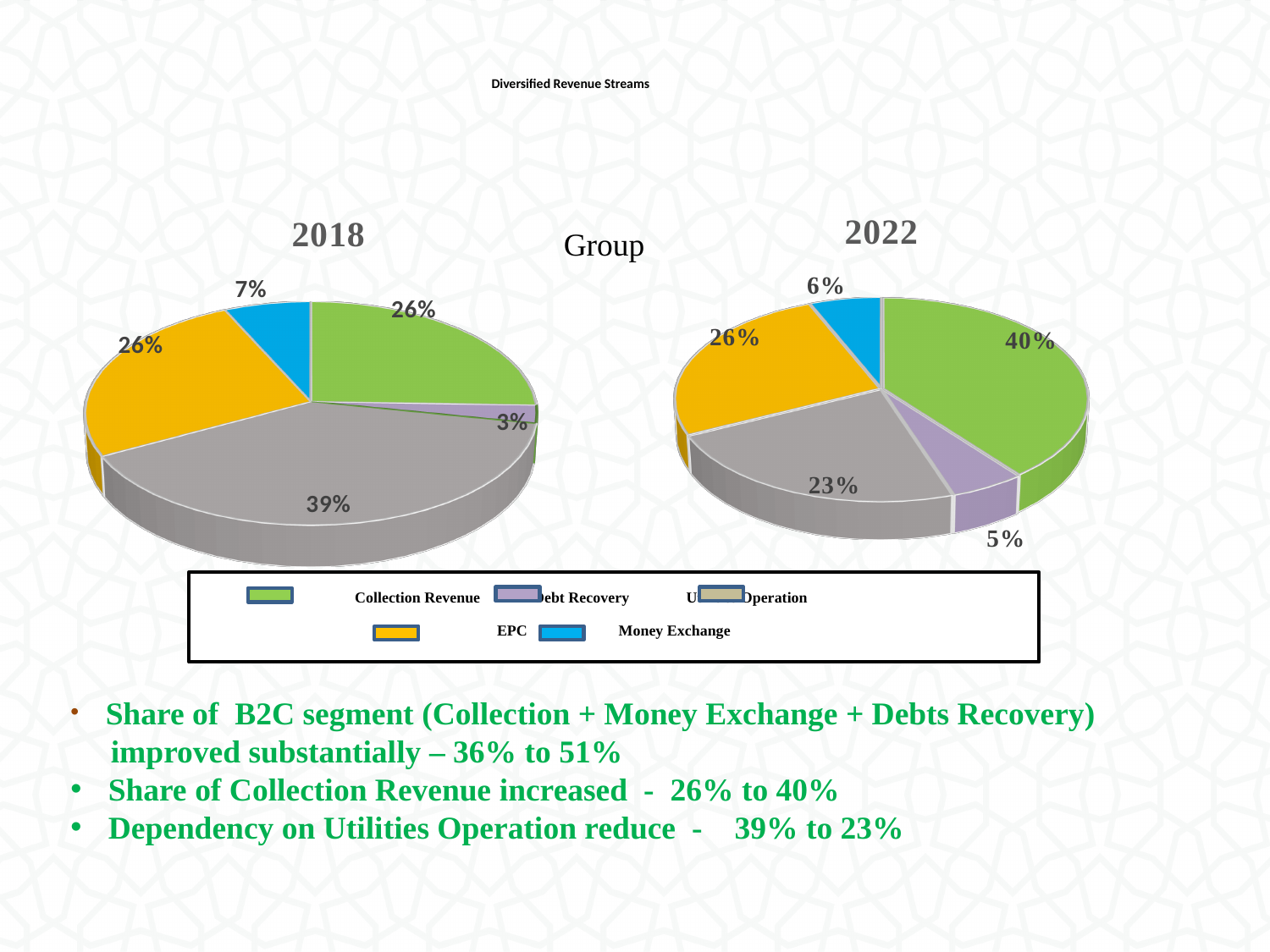
In the 2022 pie chart, which is larger: the share for EPC or the share for Utilities Operation? EPC In the 2022 pie chart, what share does Collection Revenue have? 40% In the legend, which category is shown in yellow? EPC What is the difference between the Utilities Operation share in the 2018 chart and in the 2022 chart? 16% What type of chart is used to show the 2018 and 2022 revenue streams? Pie chart In the 2022 pie chart, what share does Debt Recovery have? 5% In the 2018 pie chart, what share does Utilities Operation have? 39% How many categories does the legend list for the pie charts? 5 In the 2018 pie chart, what share does Money Exchange have? 7% In the 2022 pie chart, which category has the smallest share? Debt Recovery In the 2018 pie chart, which category has the smallest share? Debt Recovery In the 2018 pie chart, which category has the largest share? Utilities Operation